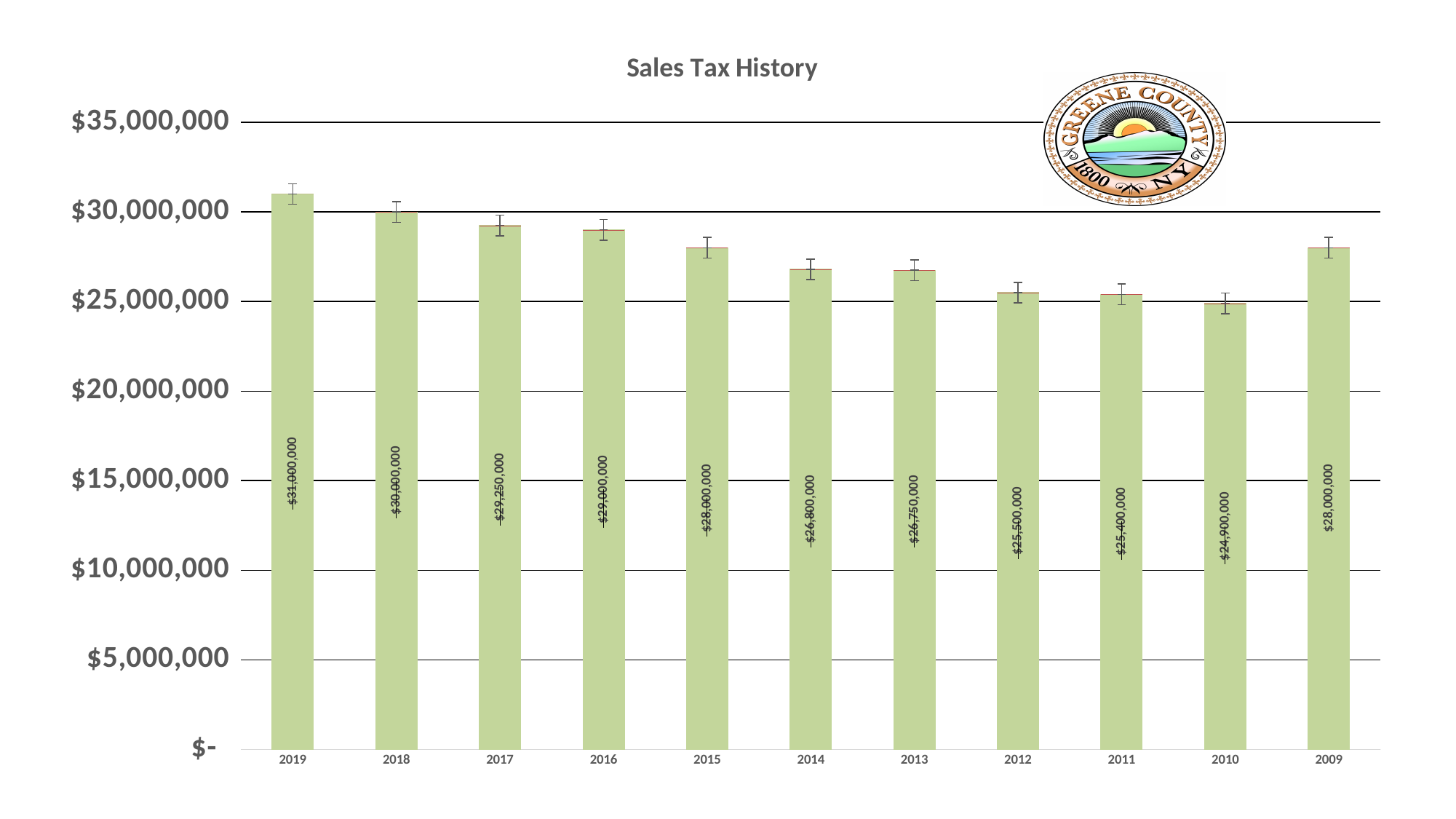
What is the sales tax value for 2010? $24,900,000 Which year has the larger sales tax value, 2015 or 2012? 2015 Which year has the highest sales tax value? 2019 Is the sales tax value for 2011 greater or less than $30,000,000? less What kind of chart is shown on the slide? bar chart What is the difference between the sales tax values for 2019 and 2018? $1,000,000 What is the sales tax value for 2017? $29,250,000 What is the sales tax value for 2019? $31,000,000 What is the title of the chart? Sales Tax History How many years are shown on the x axis of the chart? 11 Which year has the lowest sales tax value? 2010 Reading from 2018 to 2010 along the x axis, do the sales tax values rise or fall? fall